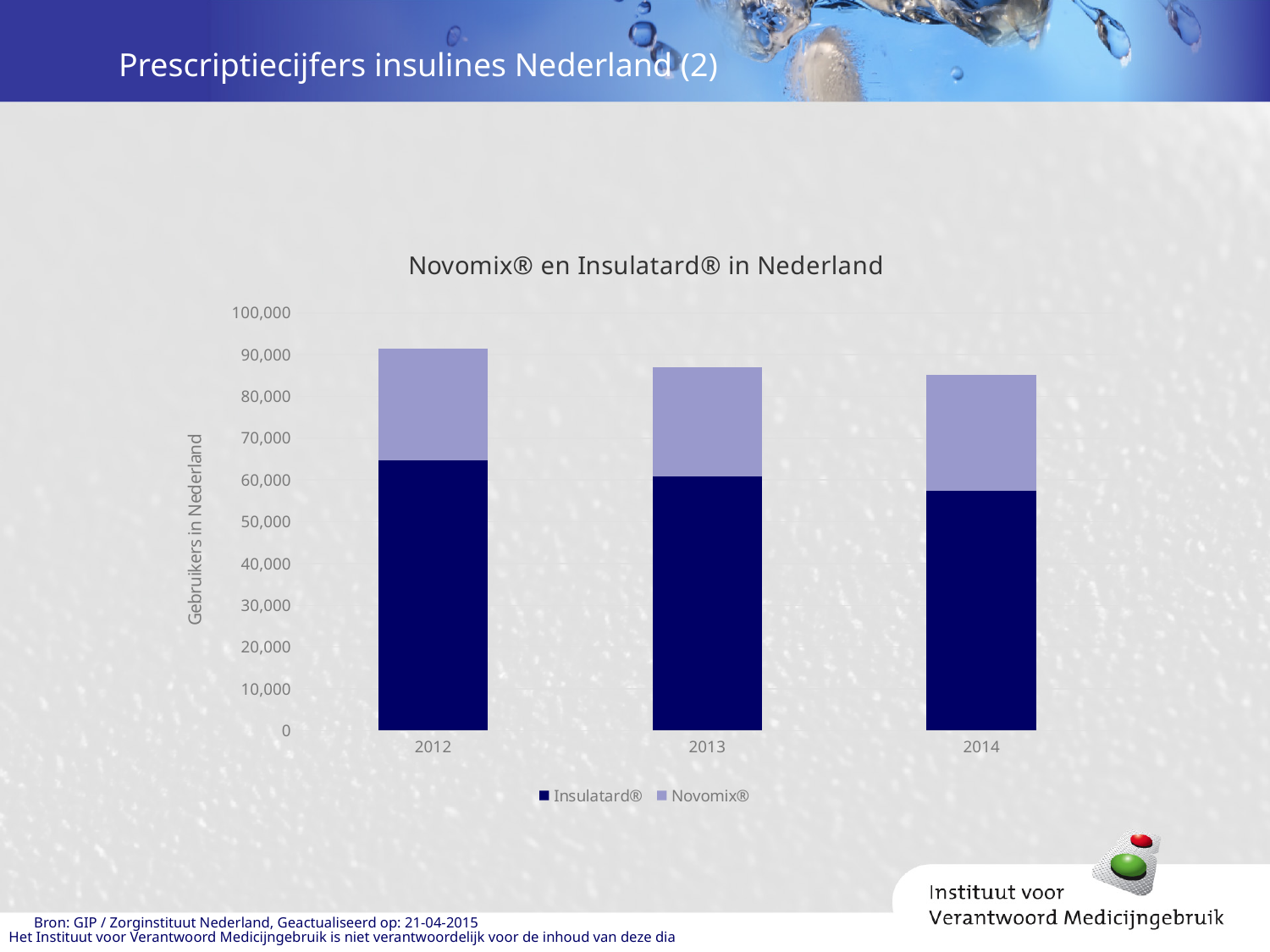
What kind of chart is shown on the slide? Stacked bar chart Is the Insulatard® value for 2014 greater or less than 60,000? less Is the Insulatard® value for 2012 greater or less than 60,000? greater How many years are shown on the x axis of the chart? 3 What is the title of the chart? Novomix® en Insulatard® in Nederland Do the Insulatard® values rise or fall from 2012 to 2014? fall In which year is the Insulatard® value highest? 2012 In which year is the Insulatard® value lowest? 2014 How many series does the chart legend list? 2 Which year has the highest total stacked bar? 2012 Which series are listed in the chart legend? Insulatard® and Novomix® Is the total stacked bar for 2014 greater or less than 90,000? less